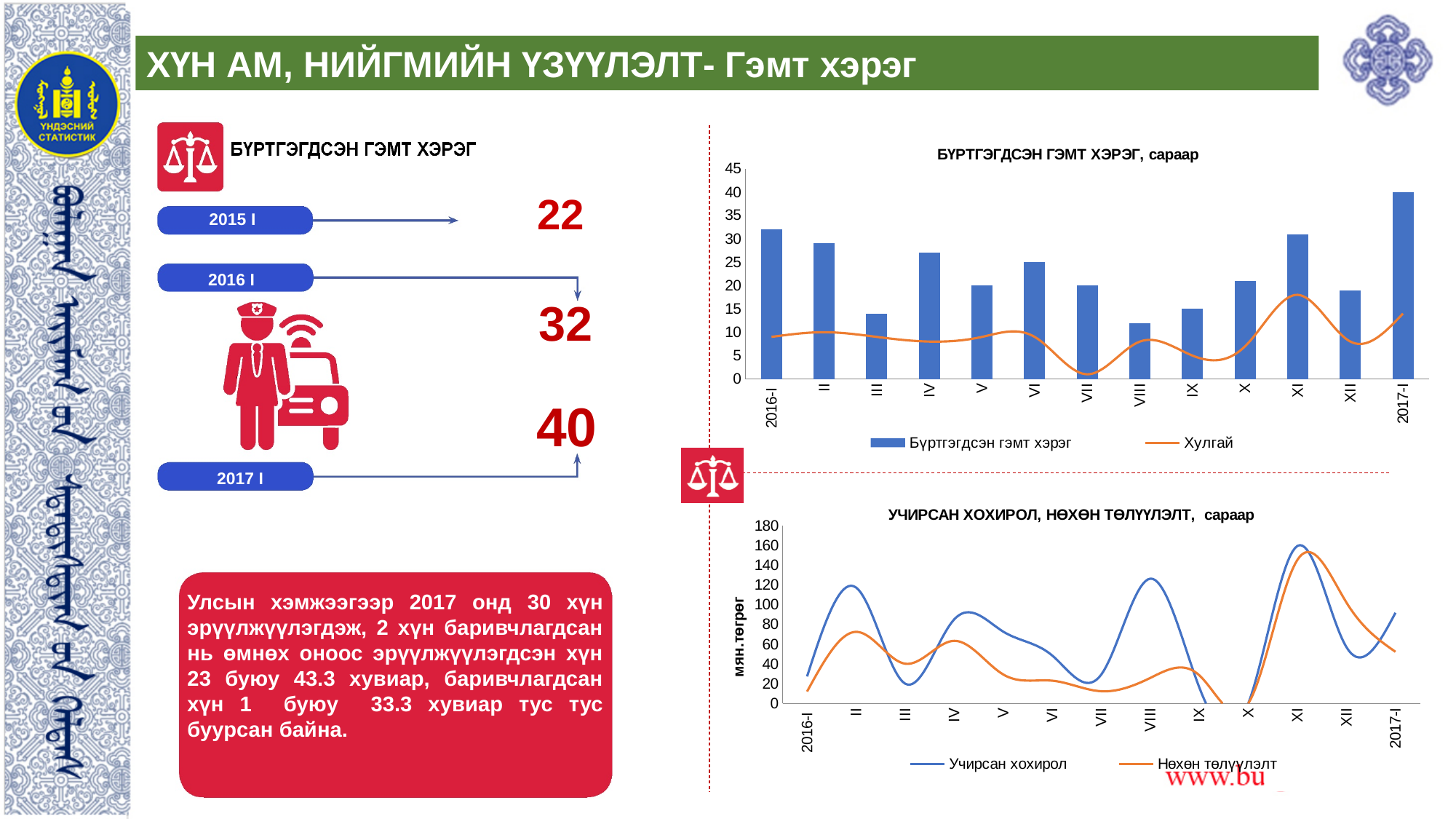
In the bottom chart 'УЧИРСАН ХОХИРОЛ, НӨХӨН ТӨЛҮҮЛЭЛТ, сараар', is the Учирсан хохирол value for VIII greater or less than 100? greater In the top chart 'БҮРТГЭГДСЭН ГЭМТ ХЭРЭГ, сараар', which month has the lowest bar for Бүртгэгдсэн гэмт хэрэг? VIII In the bottom chart 'УЧИРСАН ХОХИРОЛ, НӨХӨН ТӨЛҮҮЛЭЛТ, сараар', how many series does the legend list? 2 In the top chart 'БҮРТГЭГДСЭН ГЭМТ ХЭРЭГ, сараар', how many categories are shown on the x axis? 13 In the top chart 'БҮРТГЭГДСЭН ГЭМТ ХЭРЭГ, сараар', what is the difference between the Бүртгэгдсэн гэмт хэрэг values for 2017-I and 2016-I? 8 In the top chart 'БҮРТГЭГДСЭН ГЭМТ ХЭРЭГ, сараар', is the Бүртгэгдсэн гэмт хэрэг value for XI greater or less than 25? greater In the top chart 'БҮРТГЭГДСЭН ГЭМТ ХЭРЭГ, сараар', which month has the highest bar for Бүртгэгдсэн гэмт хэрэг? 2017-I In the bottom chart 'УЧИРСАН ХОХИРОЛ, НӨХӨН ТӨЛҮҮЛЭЛТ, сараар', in which month does Учирсан хохирол reach its highest point? XI In the top chart 'БҮРТГЭГДСЭН ГЭМТ ХЭРЭГ, сараар', what is the value of Бүртгэгдсэн гэмт хэрэг for 2017-I? 40 In the top chart 'БҮРТГЭГДСЭН ГЭМТ ХЭРЭГ, сараар', which is larger for Бүртгэгдсэн гэмт хэрэг: XI or XII? XI In the top chart 'БҮРТГЭГДСЭН ГЭМТ ХЭРЭГ, сараар', how many series does the legend list? 2 What kind of chart is the bottom chart titled 'УЧИРСАН ХОХИРОЛ, НӨХӨН ТӨЛҮҮЛЭЛТ, сараар'? line chart